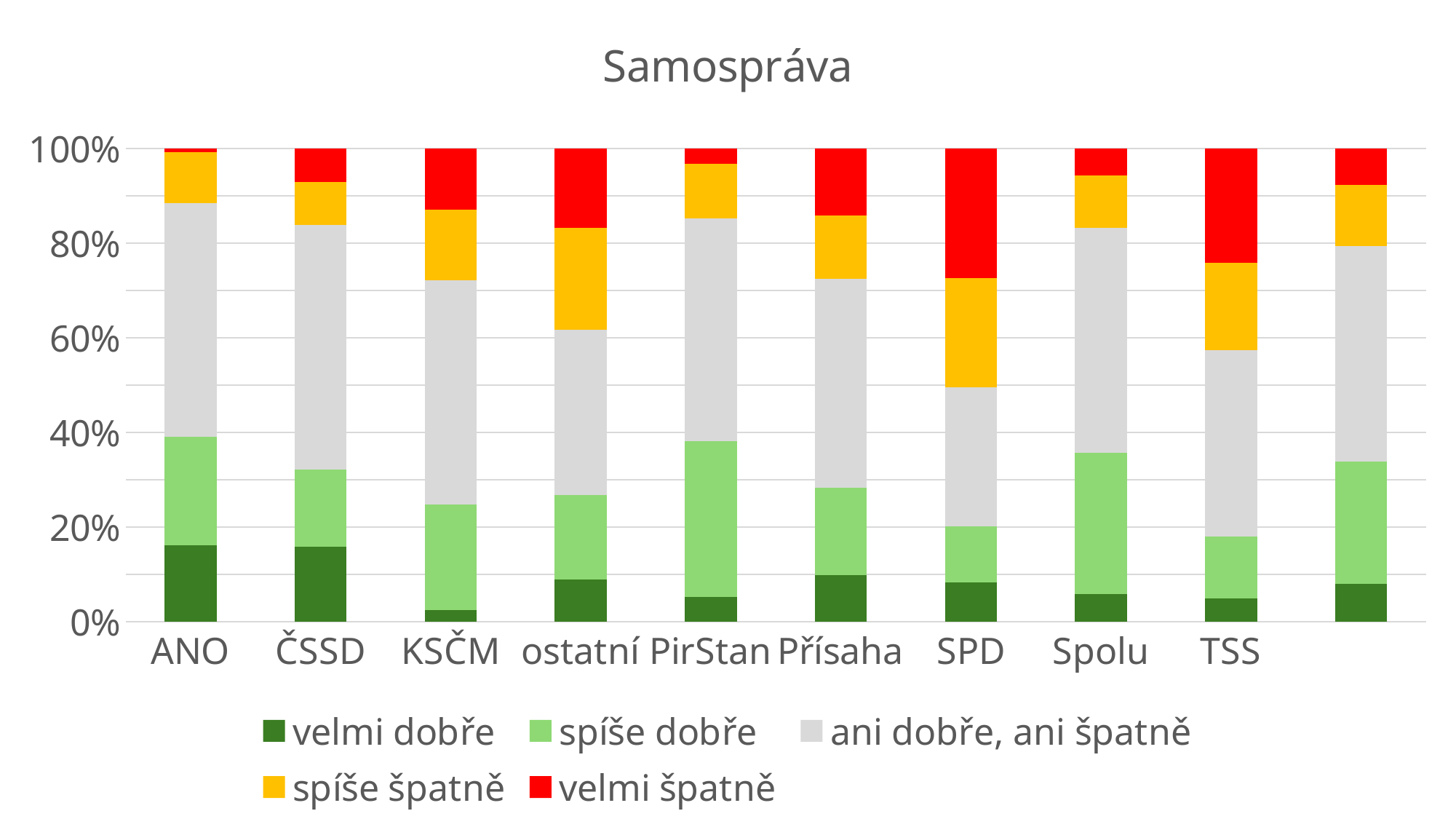
Is the "velmi špatně" share for SPD greater or less than 20%? greater Which category has the largest "velmi špatně" share? SPD What is the title of the chart? Samospráva Which colour represents the series "velmi špatně" in the legend? red Is the "velmi dobře" share for ANO larger or smaller than for KSČM? larger What kind of chart is shown on the slide? stacked bar chart Which category has the largest "spíše špatně" share? SPD How many series does the legend list? 5 Which category has the smallest "velmi dobře" share? KSČM Is the "velmi dobře" share for ANO greater or less than 20%? less Is the "velmi špatně" share for SPD larger or smaller than for ANO? larger How many bars are plotted in the chart? 10